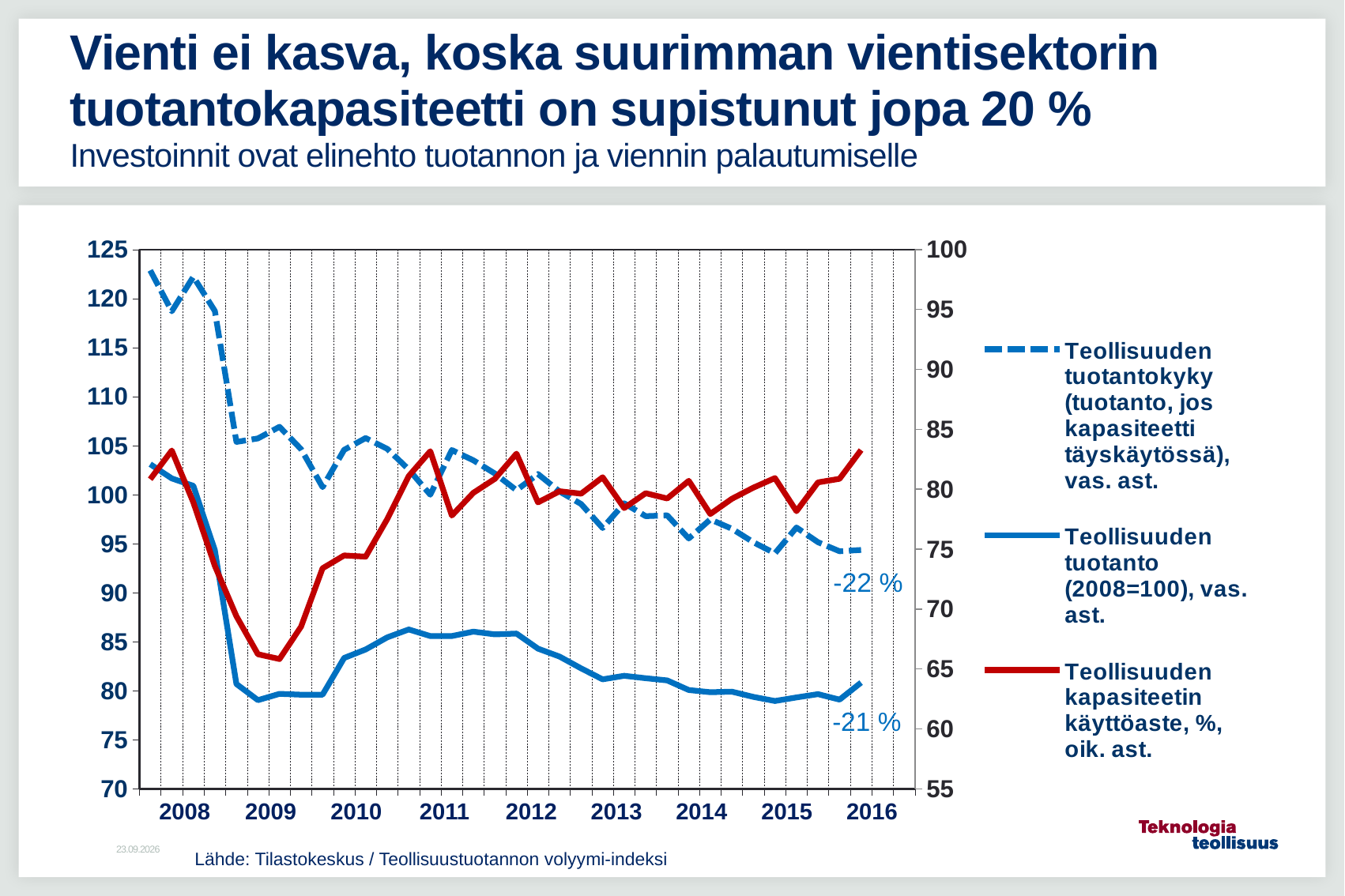
How many year labels are shown on the x axis? 9 At the end of the series in 2016, which is higher on the left axis: Teollisuuden tuotantokyky or Teollisuuden tuotanto (2008=100)? Teollisuuden tuotantokyky Is the value of Teollisuuden tuotanto (2008=100) in 2009 greater or less than 85? less How many series does the legend list? 3 What type of chart is shown on the slide? line chart Is the value of Teollisuuden tuotantokyky at the end of the series in 2016 greater or less than 100? less What percentage change is annotated next to the end of the dashed Teollisuuden tuotantokyky line? -22 % Does the Teollisuuden tuotantokyky series rise or fall overall from 2008 to 2016? fall What percentage change is annotated next to the end of the solid blue Teollisuuden tuotanto line? -21 % Does the Teollisuuden tuotanto (2008=100) series rise or fall overall from 2008 to 2016? fall Is the value of Teollisuuden tuotanto (2008=100) at the end of the series in 2016 greater or less than 85? less